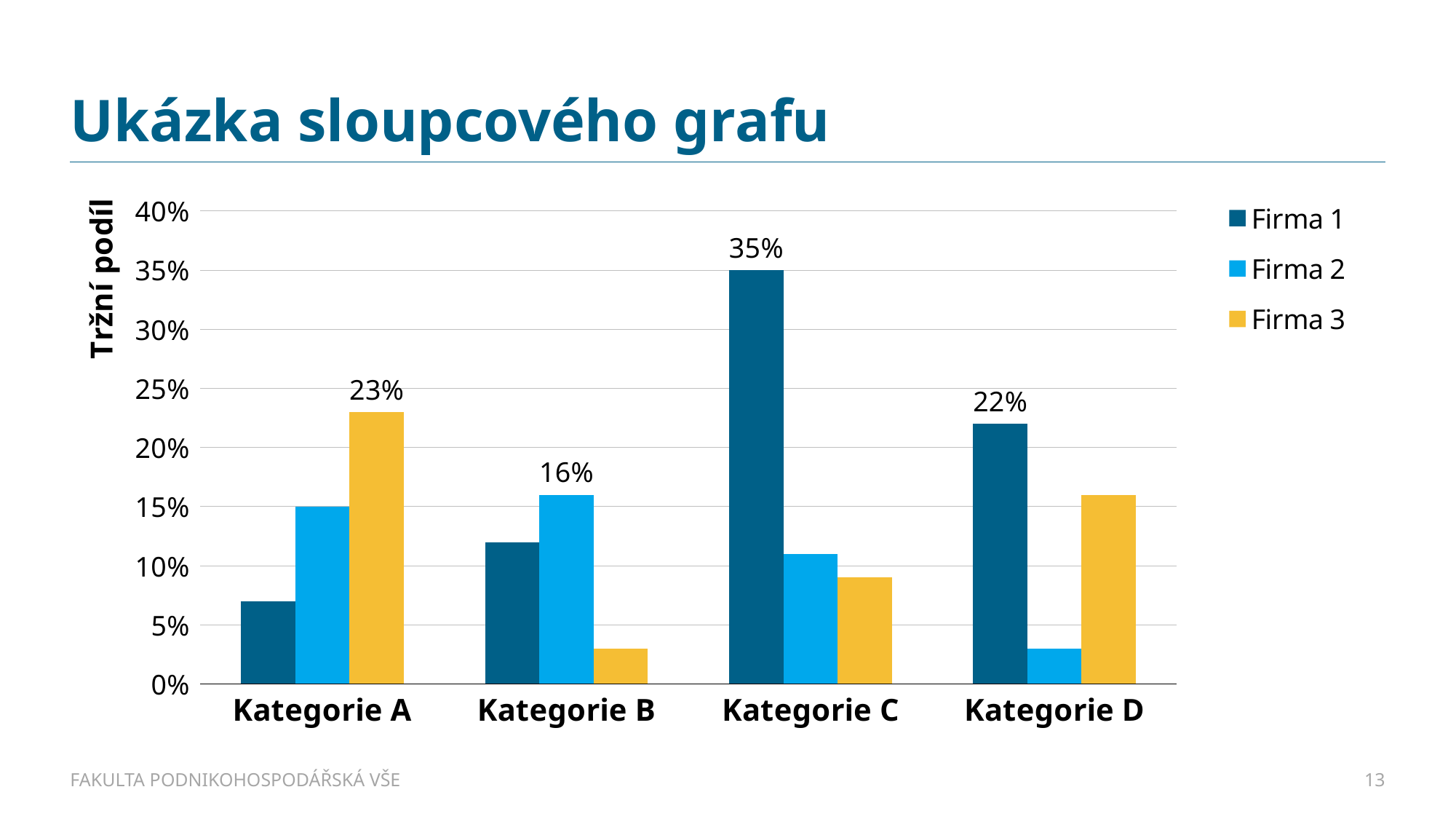
Is the value for Firma 1 in Kategorie B greater or less than 10%? greater What is the value for Firma 2 in Kategorie B? 16% What is the difference between Firma 1 in Kategorie C and Firma 1 in Kategorie D? 13% What is the value for Firma 1 in Kategorie D? 22% What is the value for Firma 3 in Kategorie A? 23% What is the value for Firma 1 in Kategorie C? 35% Which series has the lowest value in Kategorie A? Firma 1 How many categories are shown on the x axis? 4 Is the value for Firma 2 in Kategorie C greater or less than 15%? less Which is larger: Firma 3 in Kategorie A or Firma 2 in Kategorie B? Firma 3 in Kategorie A How many series does the legend list? 3 Which category has the highest bar in the chart? Kategorie C